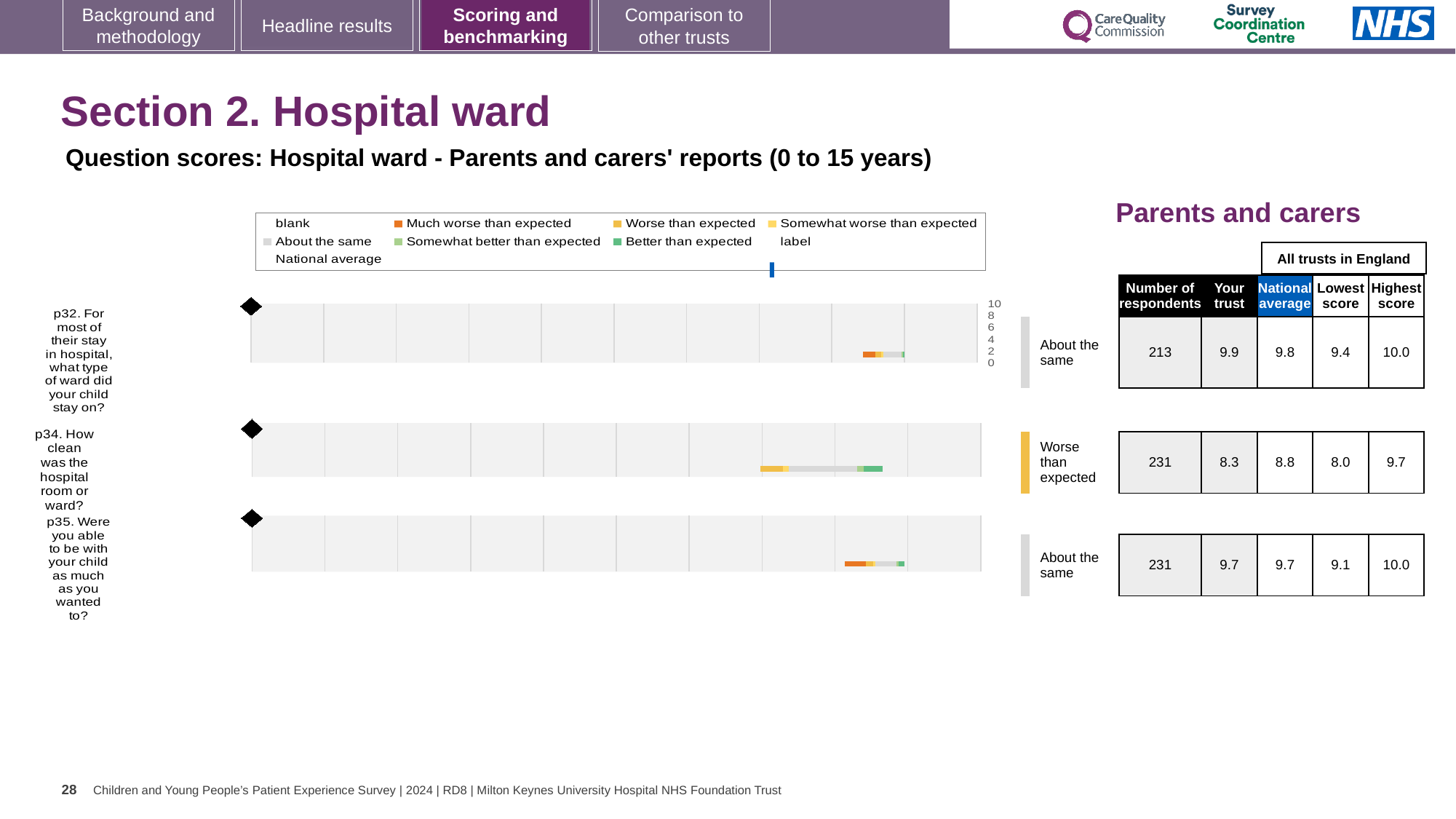
How many respondents answered question p35 (Were you able to be with your child as much as you wanted to?)? 231 For question p34, which is larger: the 'Your trust' score or the national average? National average Which question has the lowest 'Your trust' score? p34 What is the difference between the highest score and the lowest score for question p34? 1.7 How many questions are plotted on this slide? 3 Which question has the highest 'Your trust' score? p32 What is the national average score for question p32 (For most of their stay in hospital, what type of ward did your child stay on?)? 9.8 What is the 'Your trust' score for question p34 (How clean was the hospital room or ward?)? 8.3 What is the highest score among all trusts in England for question p34? 9.7 What kind of chart is used to show the question scores on this slide? Bar chart What benchmark category is shown for question p34? Worse than expected What is the lowest score among all trusts in England for question p35? 9.1